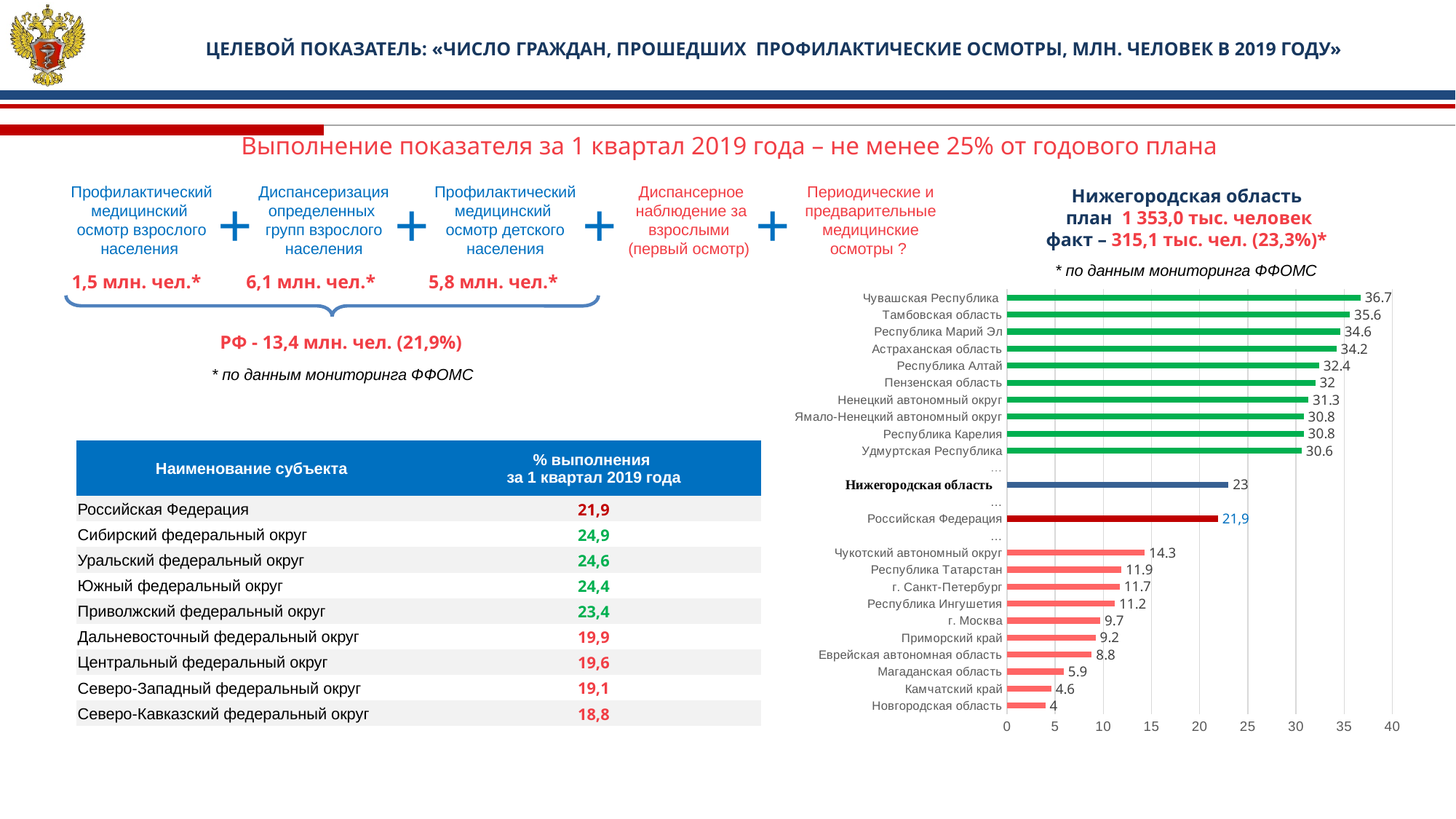
In the bar chart, is the value for Чукотский автономный округ greater or less than 15? less Which region has the highest value in the bar chart? Чувашская Республика In the bar chart, what is the difference between the values for Чувашская Республика and Тамбовская область? 1.1 What is the maximum value shown on the x axis of the bar chart? 40 What type of chart is shown on the right side of the slide? bar chart How many bars are plotted in the bar chart? 22 In the bar chart, what is the value for Чувашская Республика? 36.7 In the bar chart, what is the value for г. Москва? 9.7 Which region has the lowest value in the bar chart? Новгородская область In the bar chart, which has a larger value: Республика Татарстан or г. Санкт-Петербург? Республика Татарстан In the bar chart, what is the value for Российская Федерация? 21,9 In the bar chart, what is the value for Нижегородская область? 23